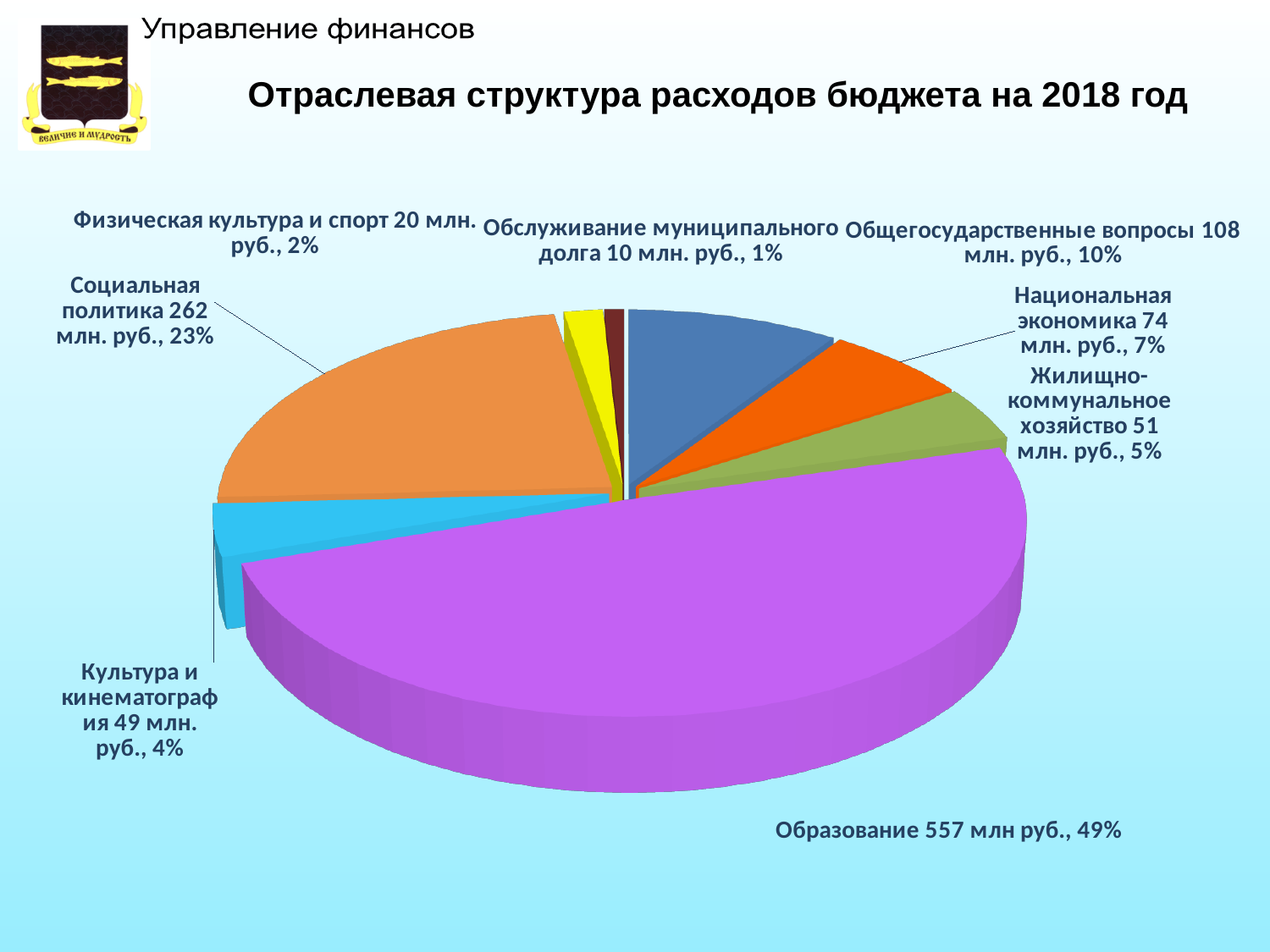
Which category has the largest slice of the pie? Образование What is the value for Культура и кинематография? 49 млн. руб. What share of the pie does Физическая культура и спорт take? 2% What kind of chart is shown on the slide? pie chart What is the value for Общегосударственные вопросы? 108 млн. руб. How many categories (slices) does the pie chart have? 8 What is the difference in млн. руб. between Социальная политика and Общегосударственные вопросы? 154 млн. руб. What share of the pie does Социальная политика take? 23% What is the value for Образование? 557 млн руб. What is the title of the chart? Отраслевая структура расходов бюджета на 2018 год Which category has the smallest slice of the pie? Обслуживание муниципального долга Which is larger, Национальная экономика or Жилищно-коммунальное хозяйство? Национальная экономика